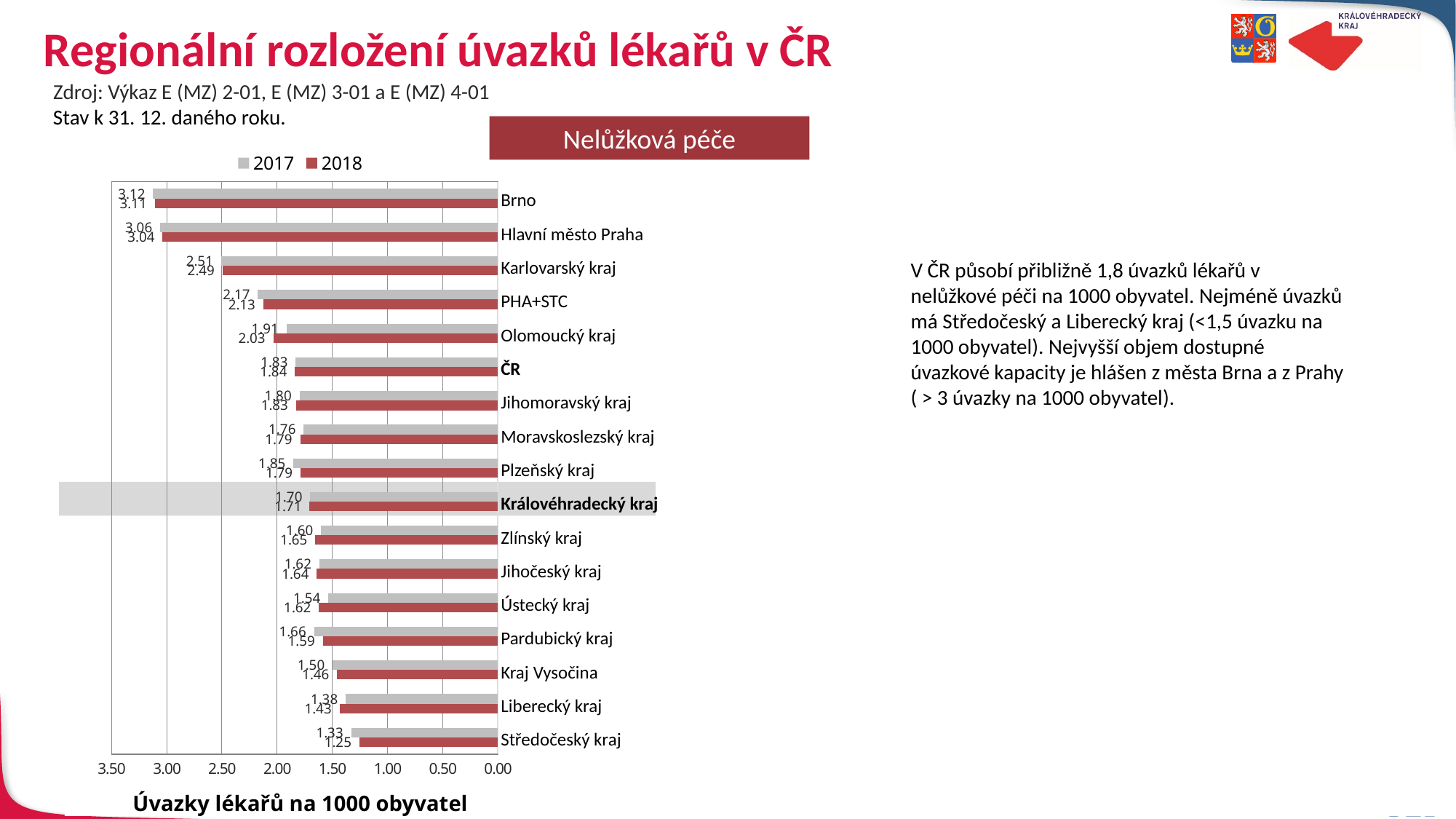
Which category has the highest 2017 value? Brno What is the difference between the 2018 values for Brno and Hlavní město Praha? 0.07 What is the 2017 value for Královéhradecký kraj? 1.70 What is the x-axis title of the chart? Úvazky lékařů na 1000 obyvatel What is the 2018 value for Olomoucký kraj? 2.03 How many categories are shown on the chart? 17 What is the 2018 value for Brno? 3.11 Which is larger, the 2017 value for Plzeňský kraj or the 2017 value for Moravskoslezský kraj? Plzeňský kraj Which category has the lowest 2018 value? Středočeský kraj How many series does the legend list? 2 What kind of chart is shown on the slide? bar chart Is the 2018 value for Karlovarský kraj greater or less than 2.00? greater